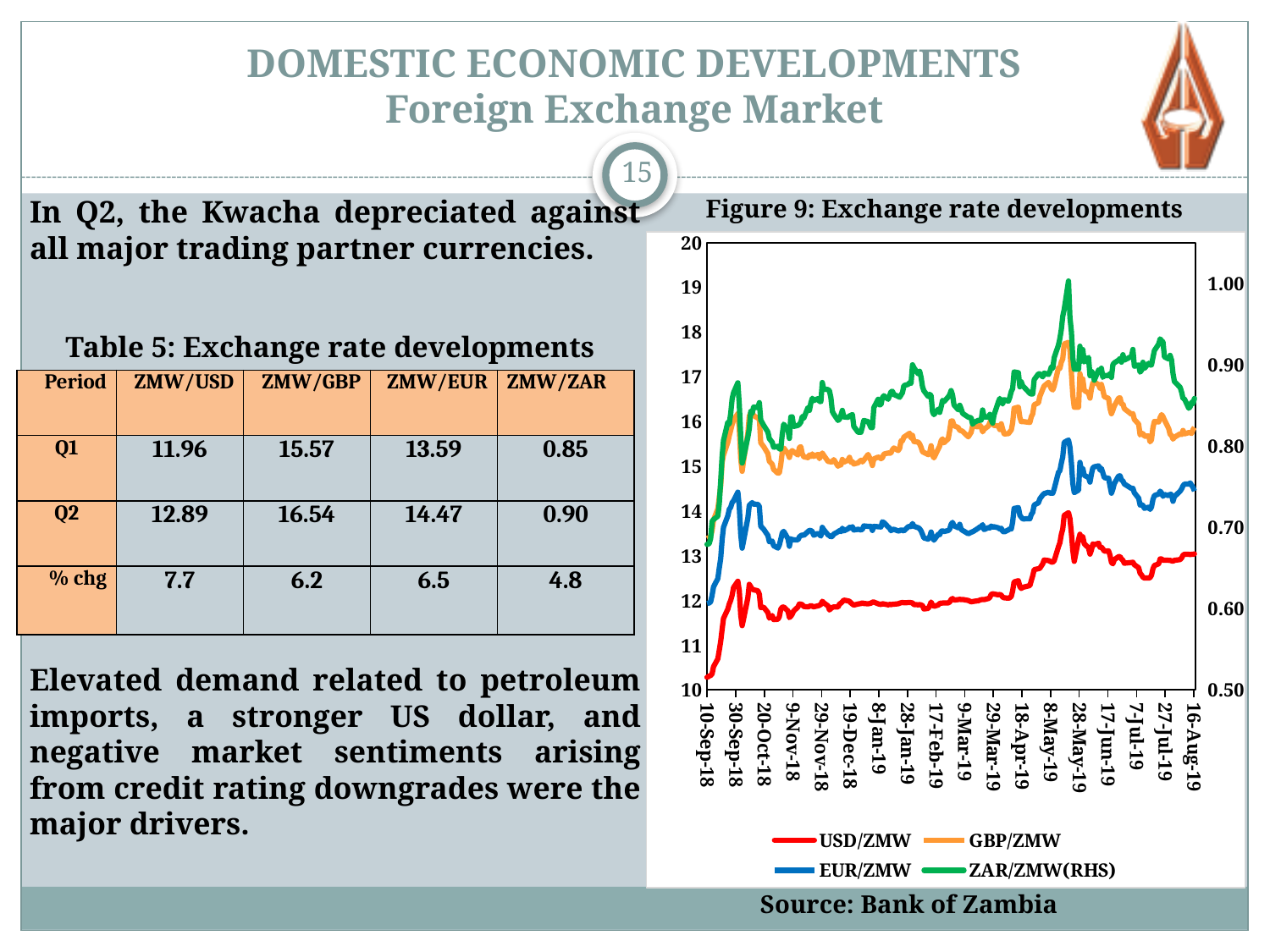
In Figure 9, is the EUR/ZMW value at 16-Aug-19 greater or less than 14? greater In Figure 9, which series is higher on the left-hand axis at 8-Jan-19, EUR/ZMW or USD/ZMW? EUR/ZMW In Figure 9, is the USD/ZMW value at 16-Aug-19 greater or less than 12? greater How many series does the legend of Figure 9 list? 4 In Figure 9, is the ZAR/ZMW (RHS) value at 16-Aug-19 greater or less than 0.80? greater In Figure 9, does the USD/ZMW series overall rise or fall from 10-Sep-18 to 16-Aug-19? rise What kind of chart is Figure 9: Exchange rate developments? line chart In Figure 9, which series is plotted on the right-hand axis (RHS)? ZAR/ZMW What is the source given for Figure 9? Bank of Zambia In Figure 9, which series is higher on the left-hand axis at 16-Aug-19, GBP/ZMW or USD/ZMW? GBP/ZMW